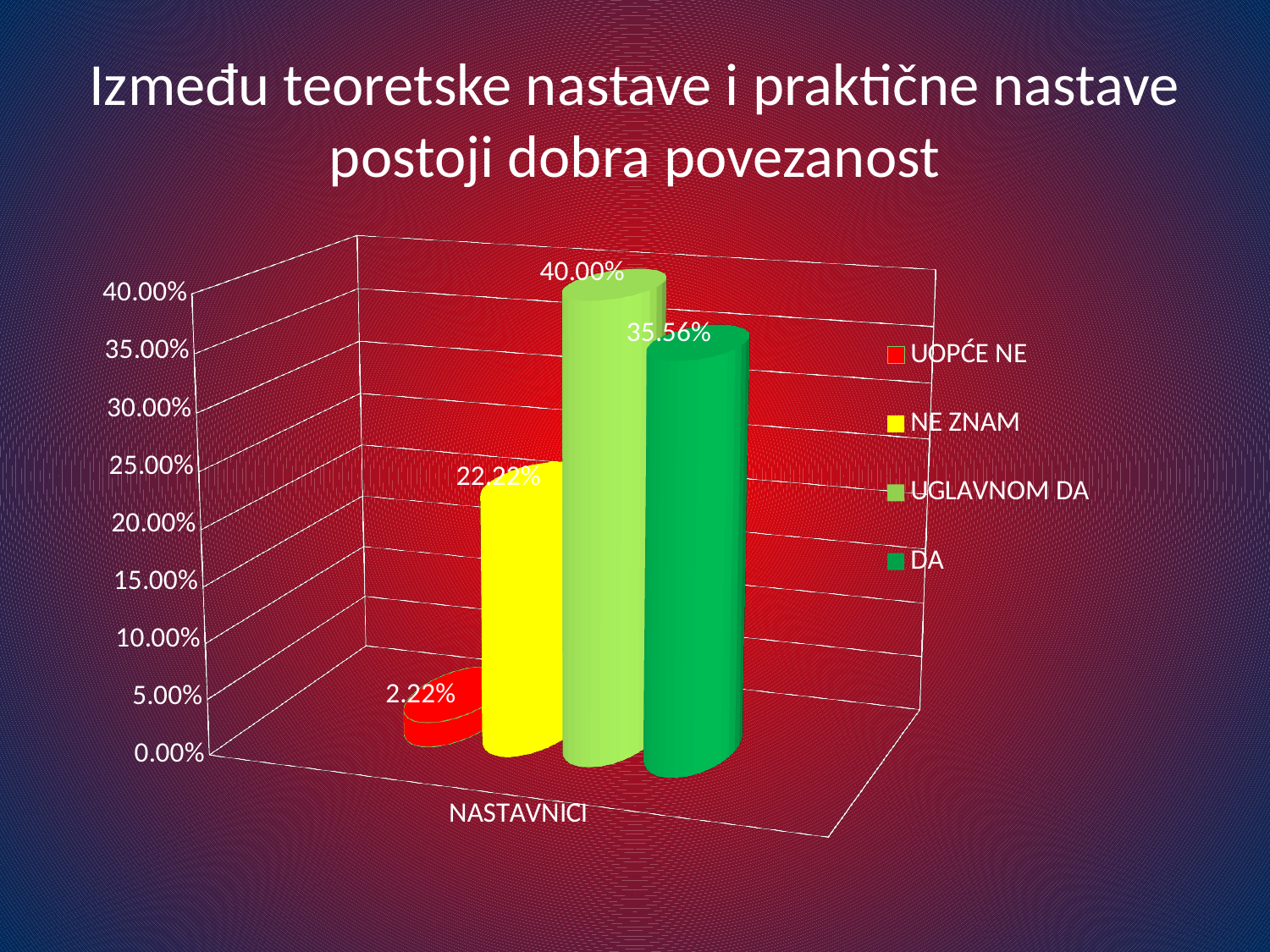
What is the value for DA? 35.56% What is the difference between the values for UGLAVNOM DA and DA? 4.44% What is the value for NE ZNAM? 22.22% What is the value for UGLAVNOM DA? 40.00% Which series has the highest value? UGLAVNOM DA What is the category label on the x axis? NASTAVNICI What is the value for UOPĆE NE? 2.22% Which series has the lowest value? UOPĆE NE What kind of chart is shown on the slide? Bar chart How many series does the legend list? 4 Which is larger, the value for NE ZNAM or the value for DA? DA What colour is the bar for NE ZNAM? Yellow